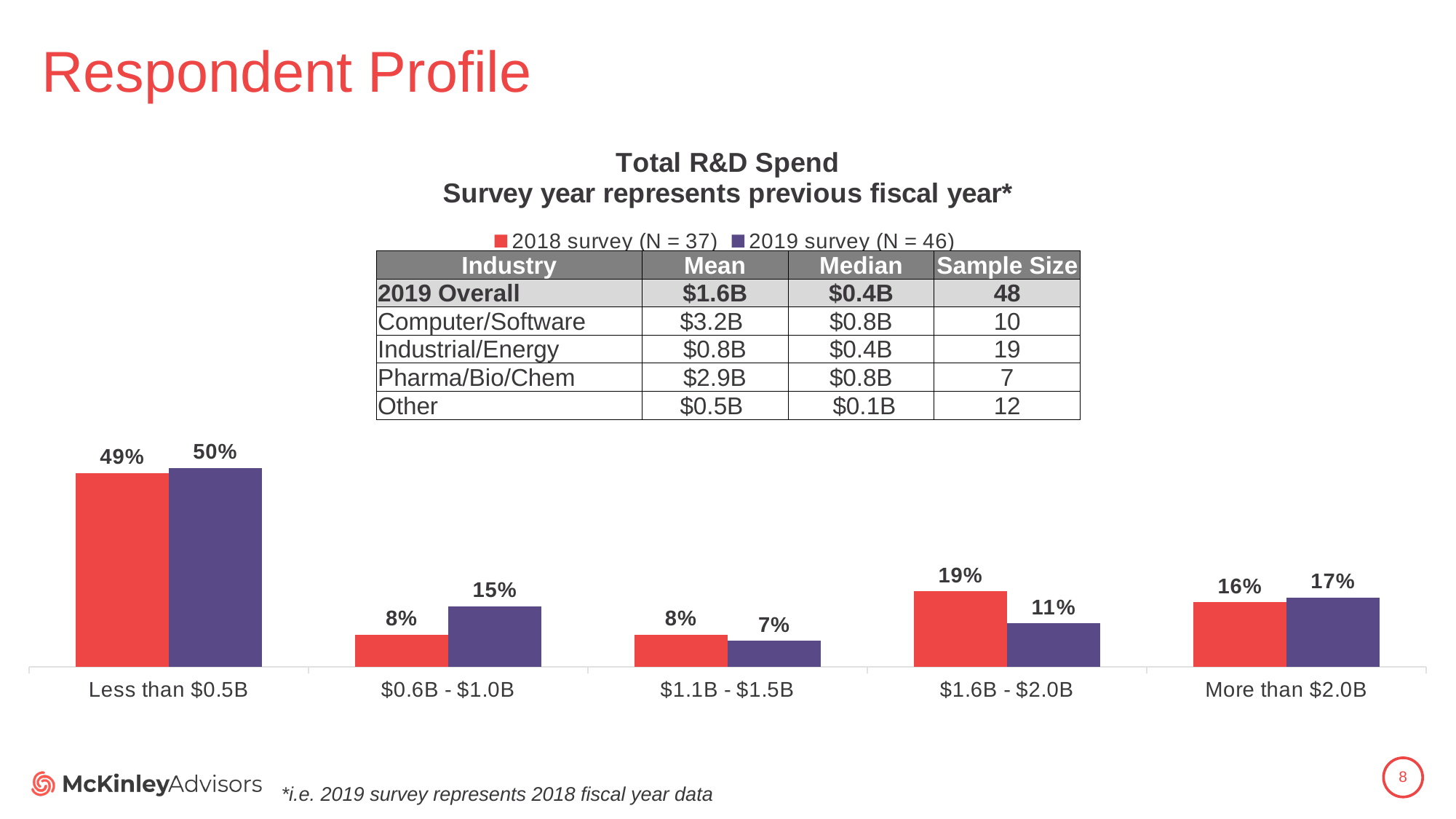
What is the difference between the 2018 and 2019 survey values for the '$1.6B - $2.0B' category? 8 percentage points How many R&D spend categories are shown on the x axis? 5 What kind of chart is shown on the slide? Bar chart What is the sample size (N) for the 2019 survey according to the legend? 46 Which category has the lowest 2018 survey value? $0.6B - $1.0B and $1.1B - $1.5B (both 8%) What is the 2019 survey value for the '$0.6B - $1.0B' category? 15% What is the 2019 survey value for the '$1.6B - $2.0B' category? 11% What is the title of the chart? Total R&D Spend Survey year represents previous fiscal year* For the '$1.1B - $1.5B' category, which survey has the larger value, 2018 or 2019? 2018 survey What is the 2018 survey value for the 'Less than $0.5B' category? 49% Which category has the highest 2019 survey value? Less than $0.5B How many series does the legend list? 2